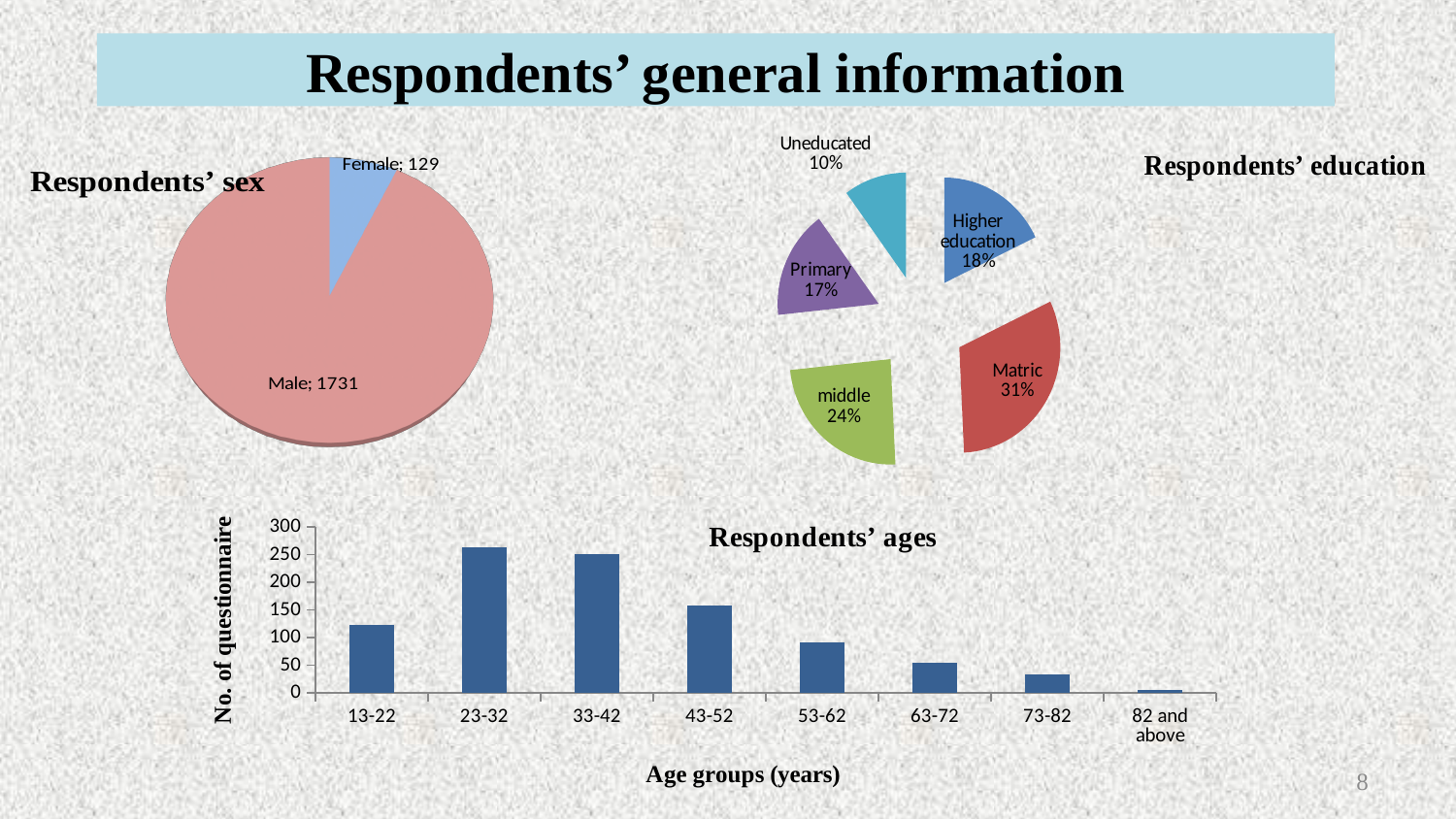
In the Respondents' education pie chart, what percentage of respondents have Matric? 31% In the Respondents' sex pie chart, what is the difference between the number of male and female respondents? 1602 In the Respondents' education pie chart, what percentage of respondents are uneducated? 10% In the Respondents' education pie chart, how many education categories are shown? 5 In the Respondents' sex pie chart, how many respondents are female? 129 In the Respondents' sex pie chart, how many respondents are male? 1731 In the Respondents' education pie chart, which education level has the largest share? Matric In the Respondents' ages bar chart, which age group has the lowest number of questionnaires? 82 and above In the Respondents' education pie chart, which education level has the smallest share? Uneducated In the Respondents' education pie chart, which is larger: the share for Primary or the share for middle? middle What kind of chart is the Respondents' ages chart? Bar chart In the Respondents' ages bar chart, is the value for the 53-62 age group greater or less than 100? less